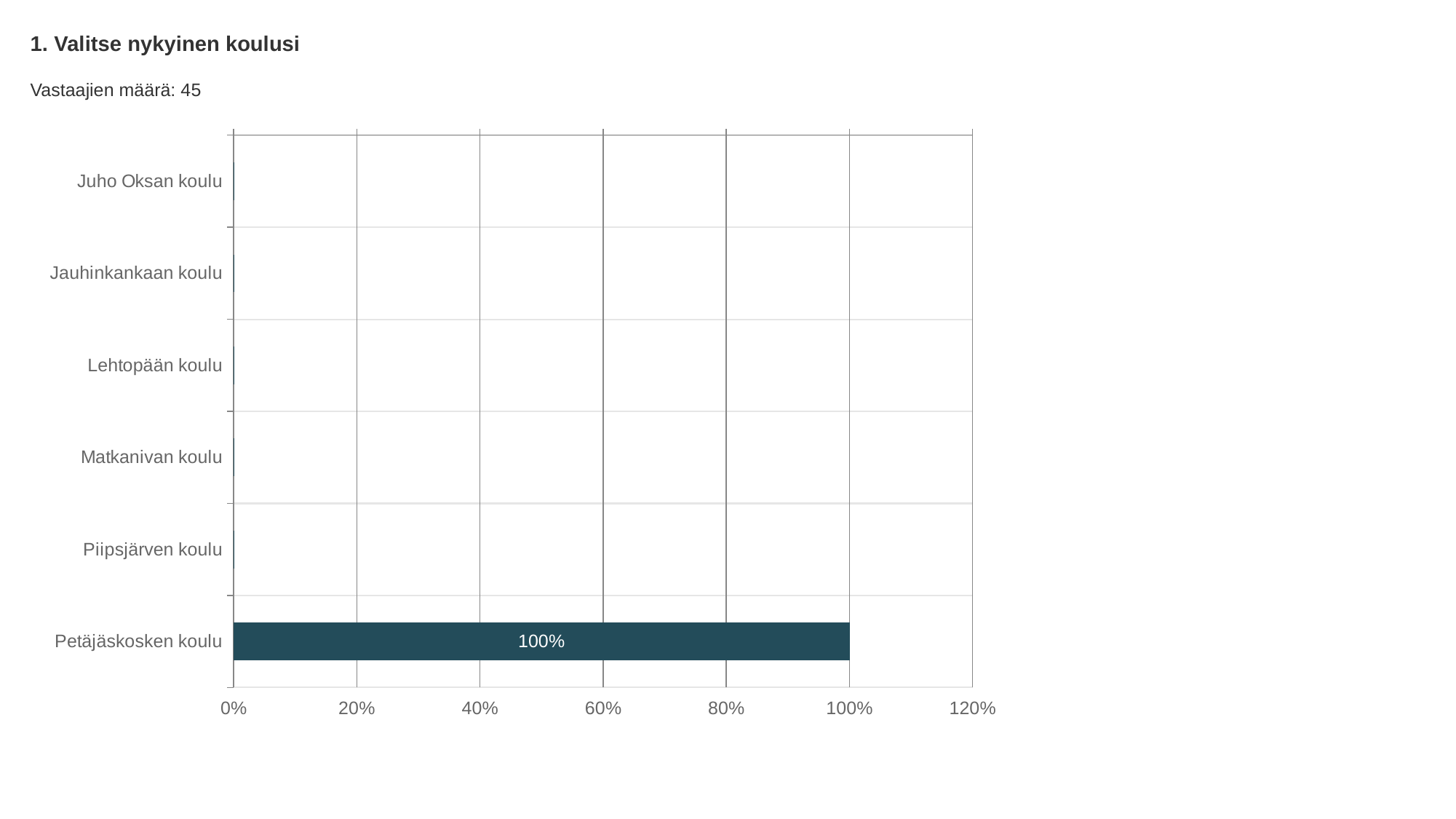
How many categories are listed on the vertical axis? 6 What is the title of the chart? 1. Valitse nykyinen koulusi How many categories have a visible bar in the chart? 1 What kind of chart is shown on the slide? Bar chart What is the value for Petäjäskosken koulu? 100% What is the highest tick label shown on the horizontal axis? 120% How many respondents (Vastaajien määrä) does the slide report? 45 Which is larger, the value for Petäjäskosken koulu or the value for Juho Oksan koulu? Petäjäskosken koulu Is the value for Petäjäskosken koulu greater or less than 80%? greater Which category has the highest value? Petäjäskosken koulu